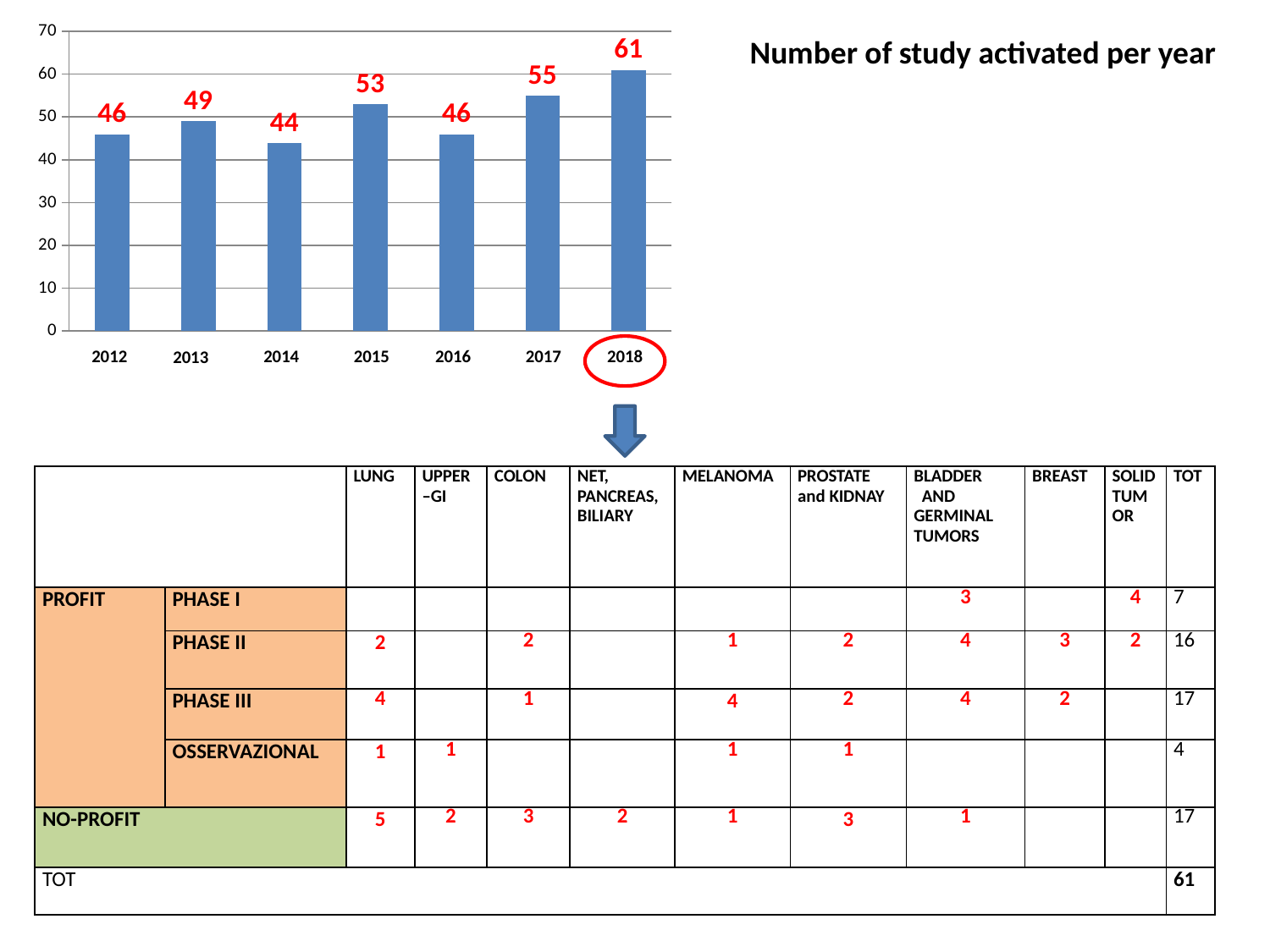
What kind of chart is shown on the slide? bar chart Which year had more studies activated, 2013 or 2016? 2013 What is the number of studies activated in 2018? 61 Which year has the lowest number of studies activated? 2014 Is the value for 2014 greater or less than 50? less What is the title of the chart? Number of study activated per year How many years are shown on the x axis of the chart? 7 Do the values generally rise or fall from 2015 to 2018? rise What is the number of studies activated in 2015? 53 Which year on the x axis is circled in red? 2018 Which year has the highest number of studies activated? 2018 What is the difference between the number of studies activated in 2018 and in 2017? 6